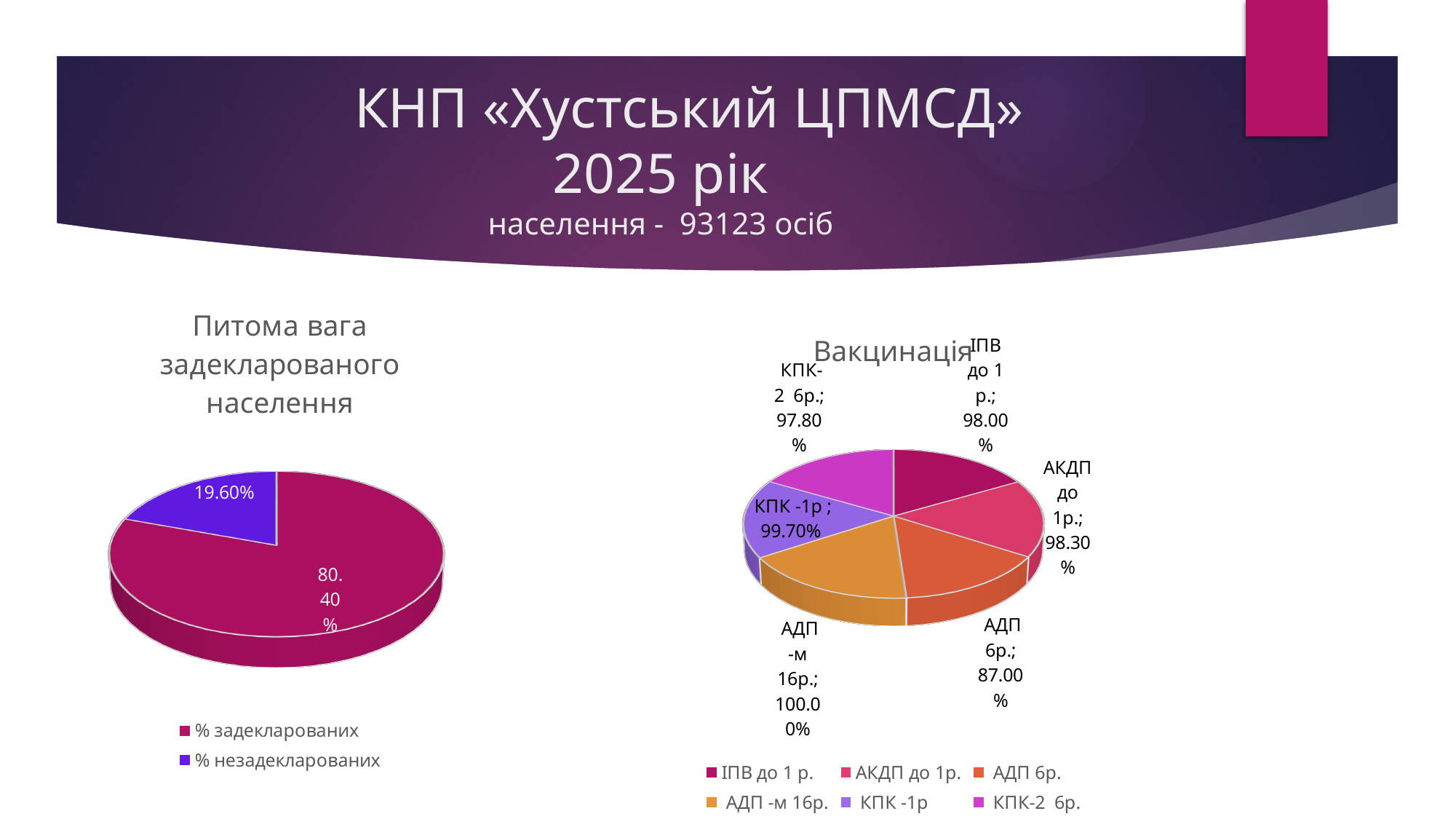
In the chart titled «Вакцинація», what is the value for «КПК -1р»? 99.70% What kind of chart is the chart titled «Питома вага задекларованого населення»? Pie chart How many charts are shown on the slide? 2 In the chart titled «Вакцинація», which category has the highest value? АДП -м 16р. In the chart titled «Питома вага задекларованого населення», what is the difference between «% задекларованих» and «% незадекларованих»? 60.80% In the chart titled «Вакцинація», what is the value for «АКДП до 1р.»? 98.30% In the chart titled «Питома вага задекларованого населення», what is the value for «% незадекларованих»? 19.60% In the chart titled «Питома вага задекларованого населення», what is the value for «% задекларованих»? 80.40% In the chart titled «Вакцинація», which category has the lowest value? АДП 6р. In the chart titled «Вакцинація», which is larger: the value for «ІПВ до 1 р.» or the value for «КПК-2 6р.»? ІПВ до 1 р. In the chart titled «Вакцинація», what is the value for «АДП 6р.»? 87.00% How many series does the legend of the chart titled «Вакцинація» list? 6